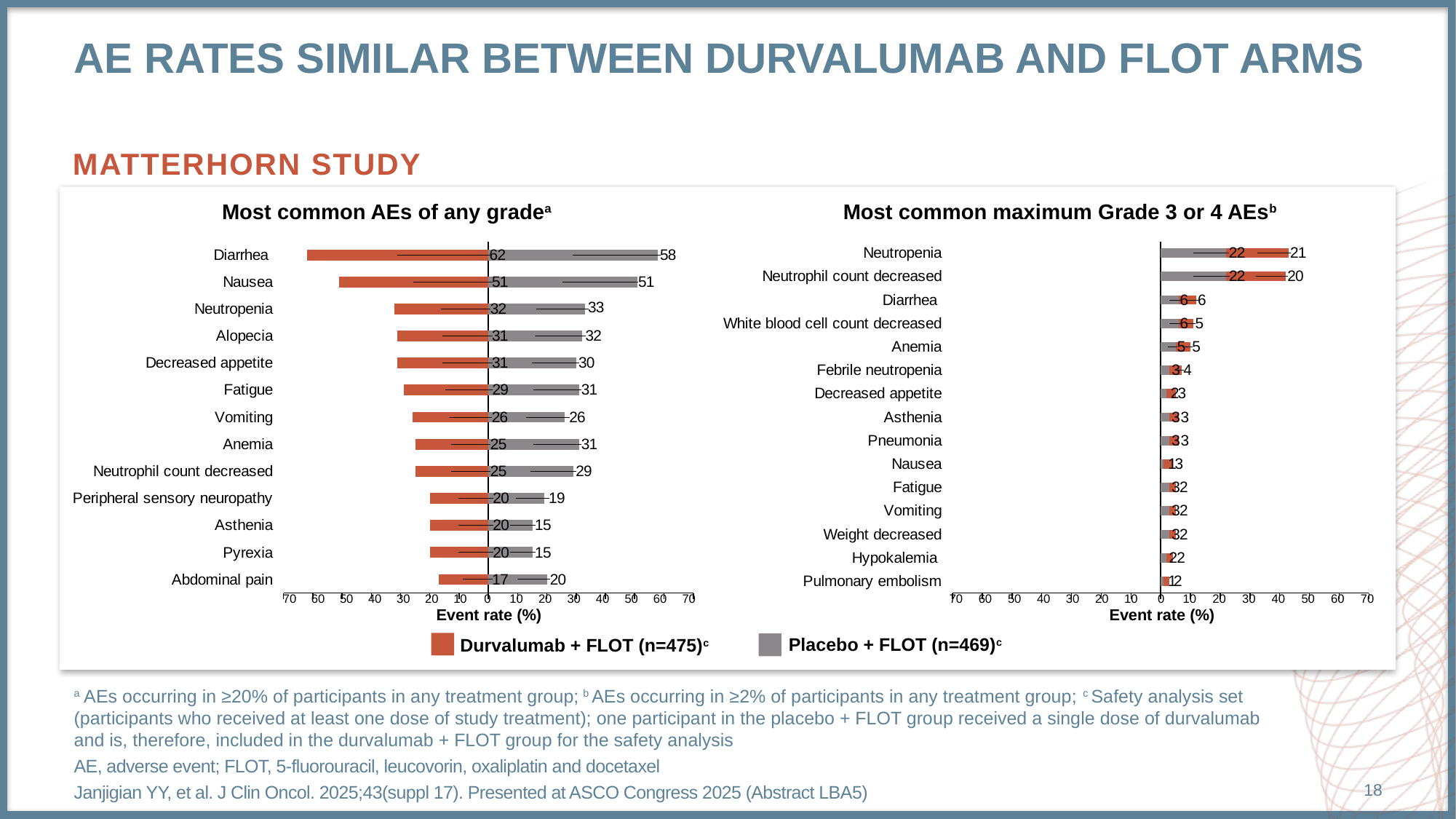
What type of chart is the 'Most common AEs of any grade' chart? Bar chart In the 'Most common AEs of any grade' chart, which adverse event has the lowest event rate in the Durvalumab + FLOT arm? Abdominal pain In the 'Most common AEs of any grade' chart, which adverse event has the highest event rate in the Durvalumab + FLOT arm? Diarrhea How many series does the legend list for the charts? 2 In the 'Most common AEs of any grade' chart, what is the event rate for Nausea in the Placebo + FLOT arm? 51 In the 'Most common AEs of any grade' chart, which arm has the higher event rate for Anemia? Placebo + FLOT How many adverse events are listed in the 'Most common AEs of any grade' chart? 13 How many adverse events are listed in the 'Most common maximum Grade 3 or 4 AEs' chart? 15 In the 'Most common maximum Grade 3 or 4 AEs' chart, what is the event rate for Neutropenia in the Placebo + FLOT arm? 22 In the 'Most common AEs of any grade' chart, what is the difference between the Durvalumab + FLOT and Placebo + FLOT event rates for Diarrhea? 4 What is the x-axis title of the 'Most common AEs of any grade' chart? Event rate (%) In the 'Most common AEs of any grade' chart, what is the event rate for Diarrhea in the Durvalumab + FLOT arm? 62